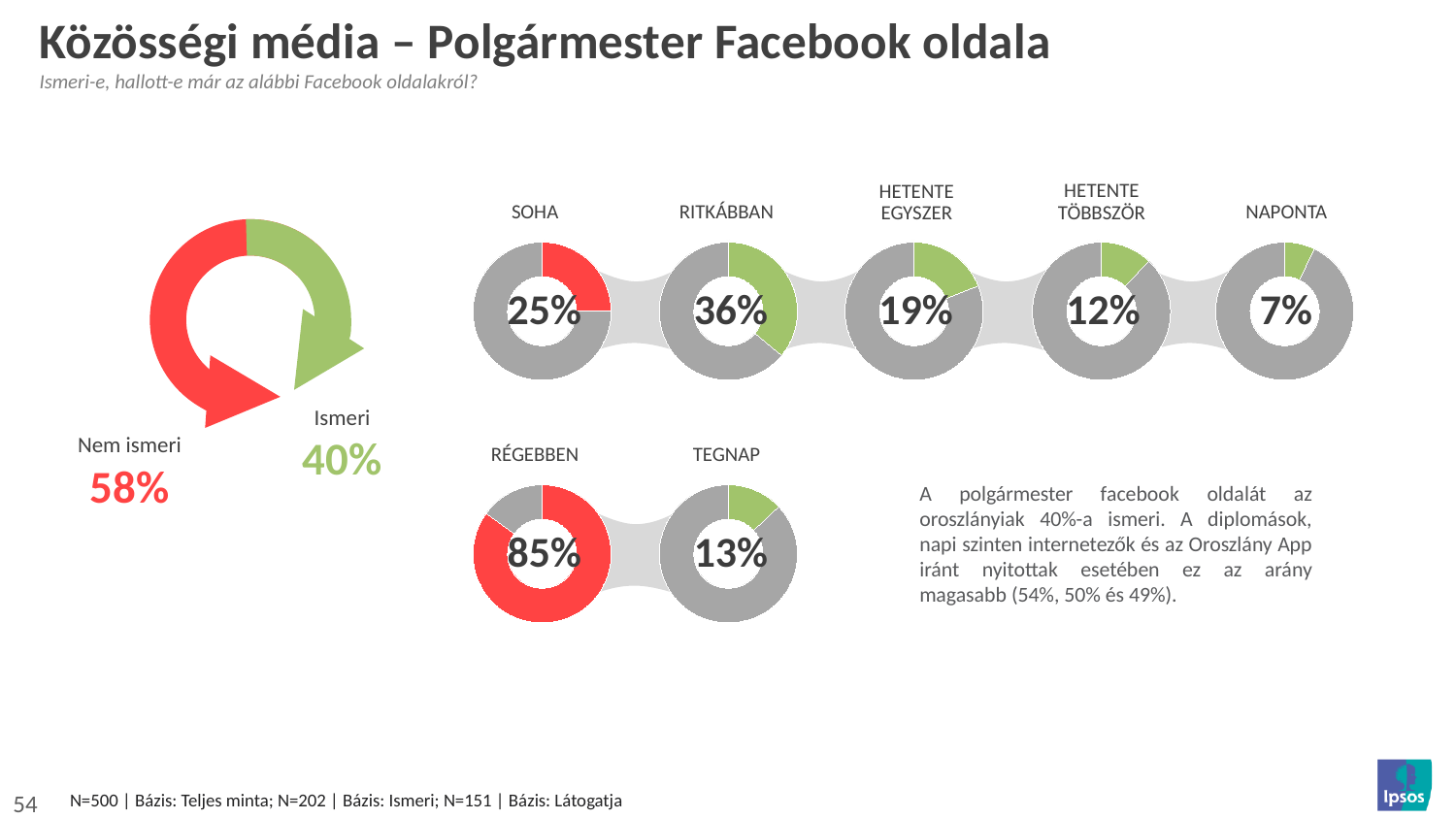
In the row of five donut charts at the top right, what percentage is shown for "NAPONTA"? 7% In the large donut chart on the left, what percentage is shown for "Nem ismeri"? 58% What kind of chart is used to show "Ismeri" and "Nem ismeri" on the left of the slide? Donut (pie) chart In the large donut chart on the left, what is the difference between "Nem ismeri" and "Ismeri"? 18 percentage points In the row of five donut charts at the top right, which category has the highest value? RITKÁBBAN In the row of five donut charts at the top right, what is the difference between "SOHA" and "HETENTE EGYSZER"? 6 percentage points In the large donut chart on the left, which segment is larger, "Ismeri" or "Nem ismeri"? Nem ismeri In the row of five donut charts at the top right, which category has the lowest value? NAPONTA In the row of five donut charts at the top right, what percentage is shown for "RITKÁBBAN"? 36% In the large donut chart on the left, what percentage is shown for "Ismeri"? 40% In the row of five donut charts at the top right, how many categories are shown? 5 In the two donut charts at the bottom middle, what percentage is shown for "RÉGEBBEN"? 85%